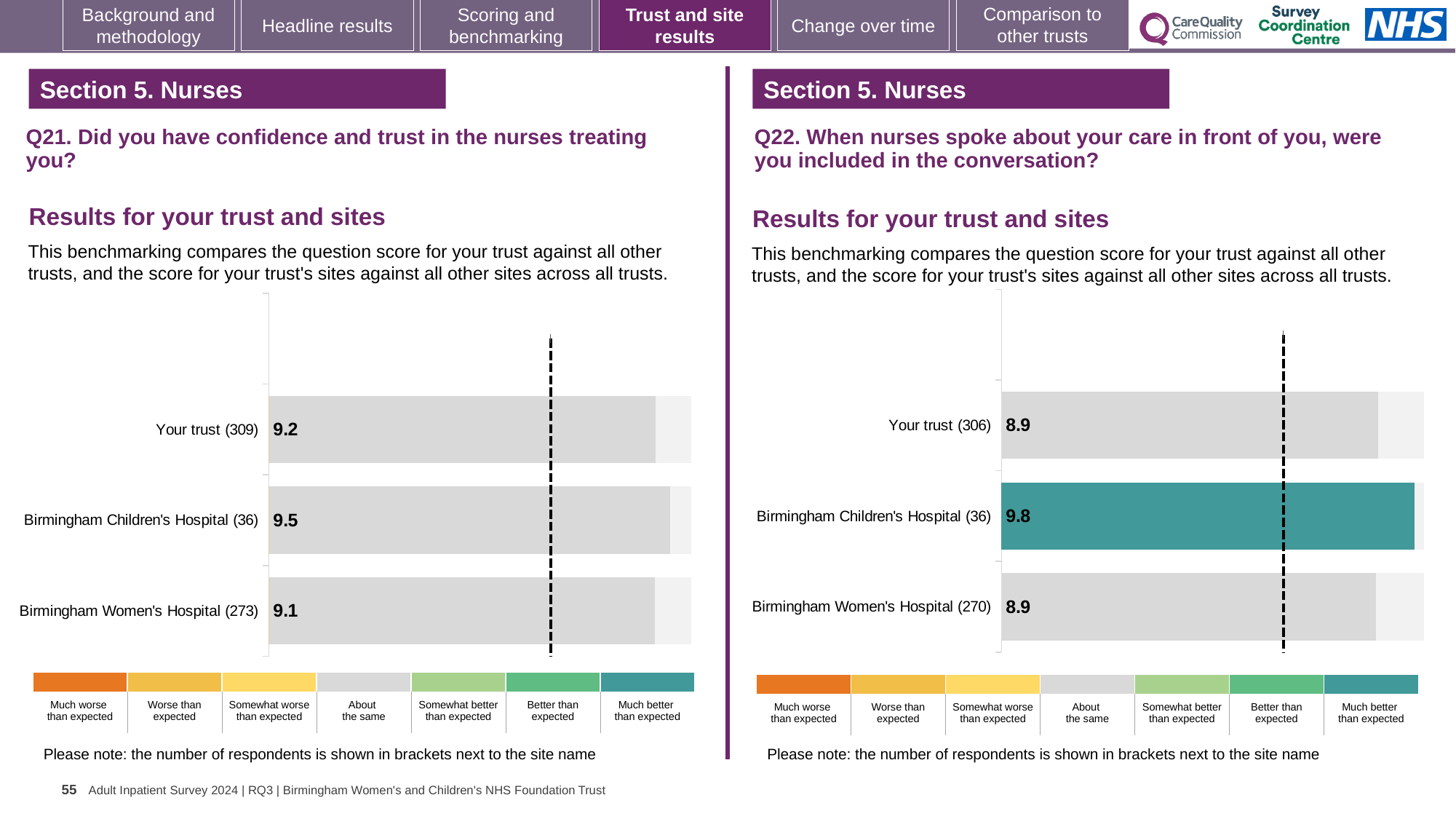
What type of chart is used in the Q21 chart on the left? Bar chart In the Q22 chart on the right, what is the score for Your trust (306)? 8.9 In the Q21 chart on the left, what is the score for Your trust (309)? 9.2 In the Q21 chart on the left, what is the difference between the scores for Birmingham Children's Hospital and Birmingham Women's Hospital? 0.4 In the Q22 chart on the right, what is the score for Birmingham Children's Hospital (36)? 9.8 In the Q22 chart on the right, how many bars are plotted? 3 In the Q21 chart on the left, what is the score for Birmingham Women's Hospital (273)? 9.1 In the Q21 chart on the left, what is the score for Birmingham Children's Hospital (36)? 9.5 In the Q22 chart on the right, which benchmark category does the colour of the Birmingham Children's Hospital bar correspond to in the legend? Much better than expected In the Q21 chart on the left, which site or trust has the highest score? Birmingham Children's Hospital (36) In the Q22 chart on the right, which site or trust has the highest score? Birmingham Children's Hospital (36) In the Q22 chart on the right, what is the difference between the scores for Birmingham Children's Hospital and Birmingham Women's Hospital? 0.9